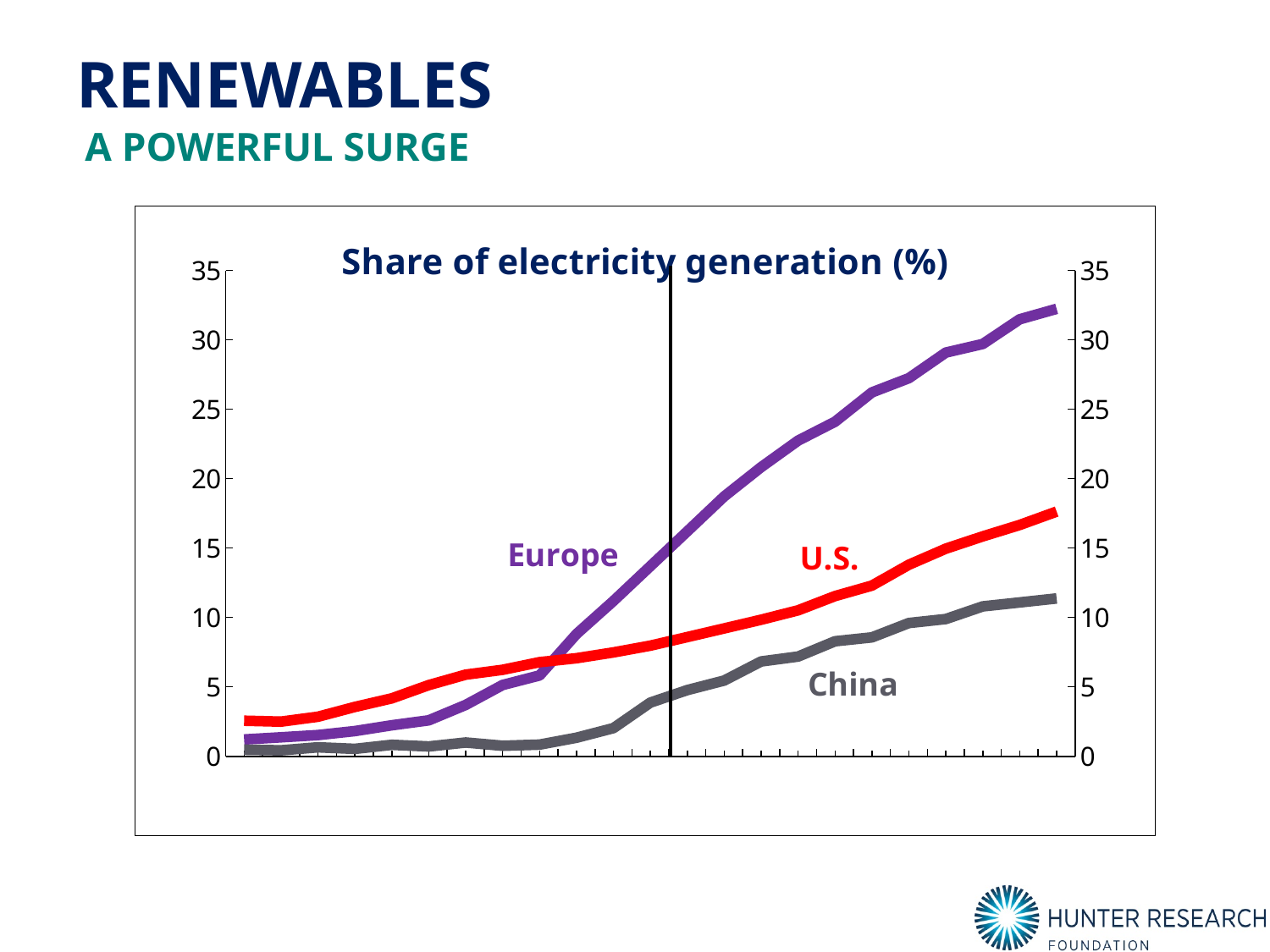
Which series has the highest value at the right end of the chart? Europe At the right end of the chart, which is larger, the value for Europe or the value for the U.S.? Europe How many series are plotted on the chart? 3 Is the value for China at the right end of the chart greater or less than 10? greater Is the value for Europe at the right end of the chart greater or less than 30? greater What is the title of the chart? Share of electricity generation (%) At the left end of the chart, which is larger, the value for the U.S. or the value for Europe? U.S. Is the value for the U.S. at the right end of the chart greater or less than 15? greater Which series has the lowest value at the right end of the chart? China What kind of chart is shown on the slide? line chart Does the Europe series rise or fall along the x axis? rise